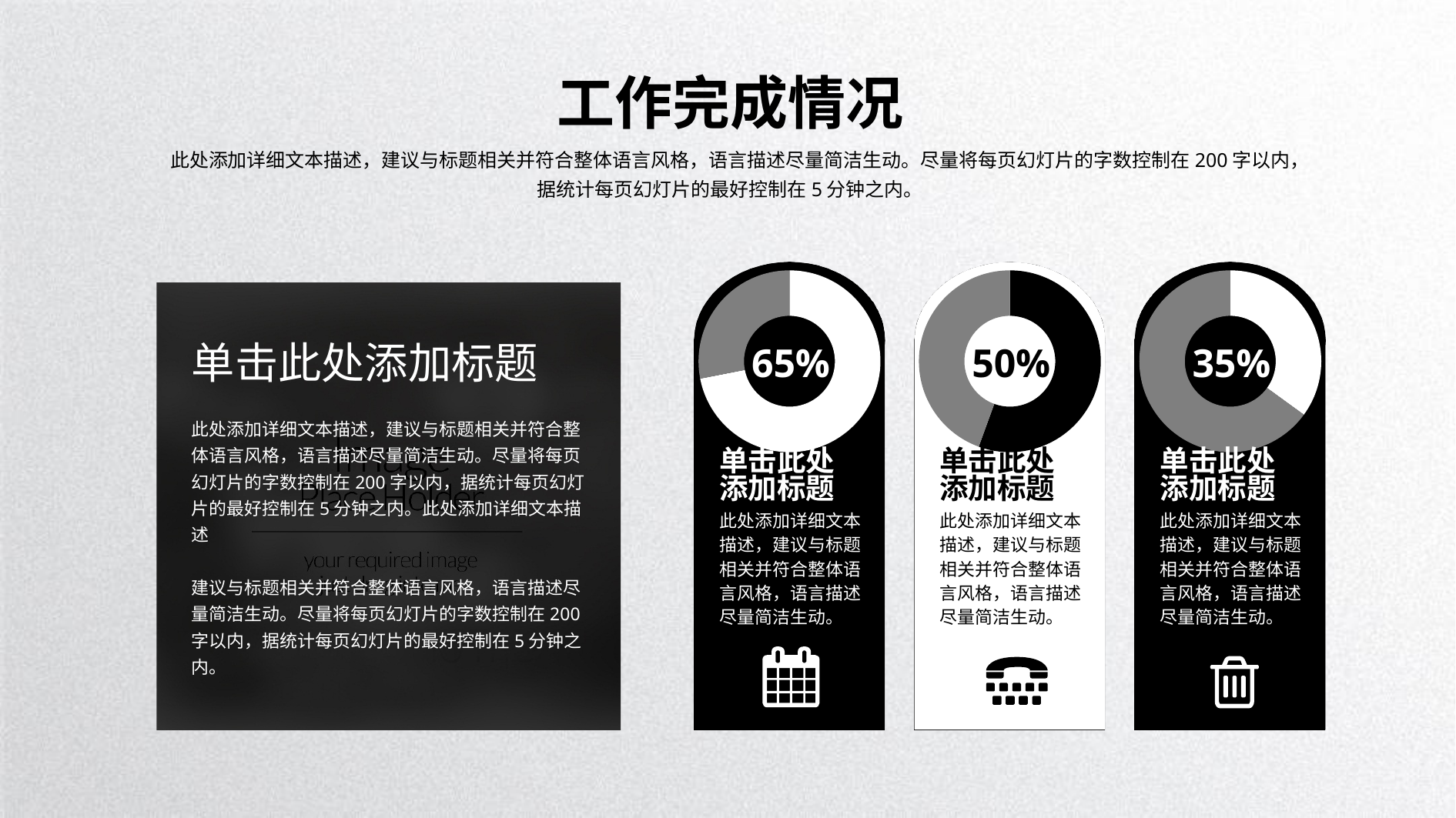
What is the title of the slide containing the three donut charts? 工作完成情况 Which of the three donut charts shows the highest percentage? The left chart (65%) Do the percentages in the donut charts increase or decrease from left to right across the slide? Decrease How many donut charts are on the slide? 3 What is the difference between the percentage in the left donut chart and the percentage in the middle donut chart? 15% What percentage is shown in the centre of the right donut chart? 35% What percentage is shown in the centre of the left donut chart? 65% What kind of chart is used in each of the three panels on the right side of the slide? Donut (pie) chart What percentage is shown in the centre of the middle donut chart? 50% Is the percentage in the middle donut chart larger or smaller than the percentage in the right donut chart? Larger Which of the three donut charts shows the lowest percentage? The right chart (35%) What is the difference between the percentage in the left donut chart and the percentage in the right donut chart? 30%